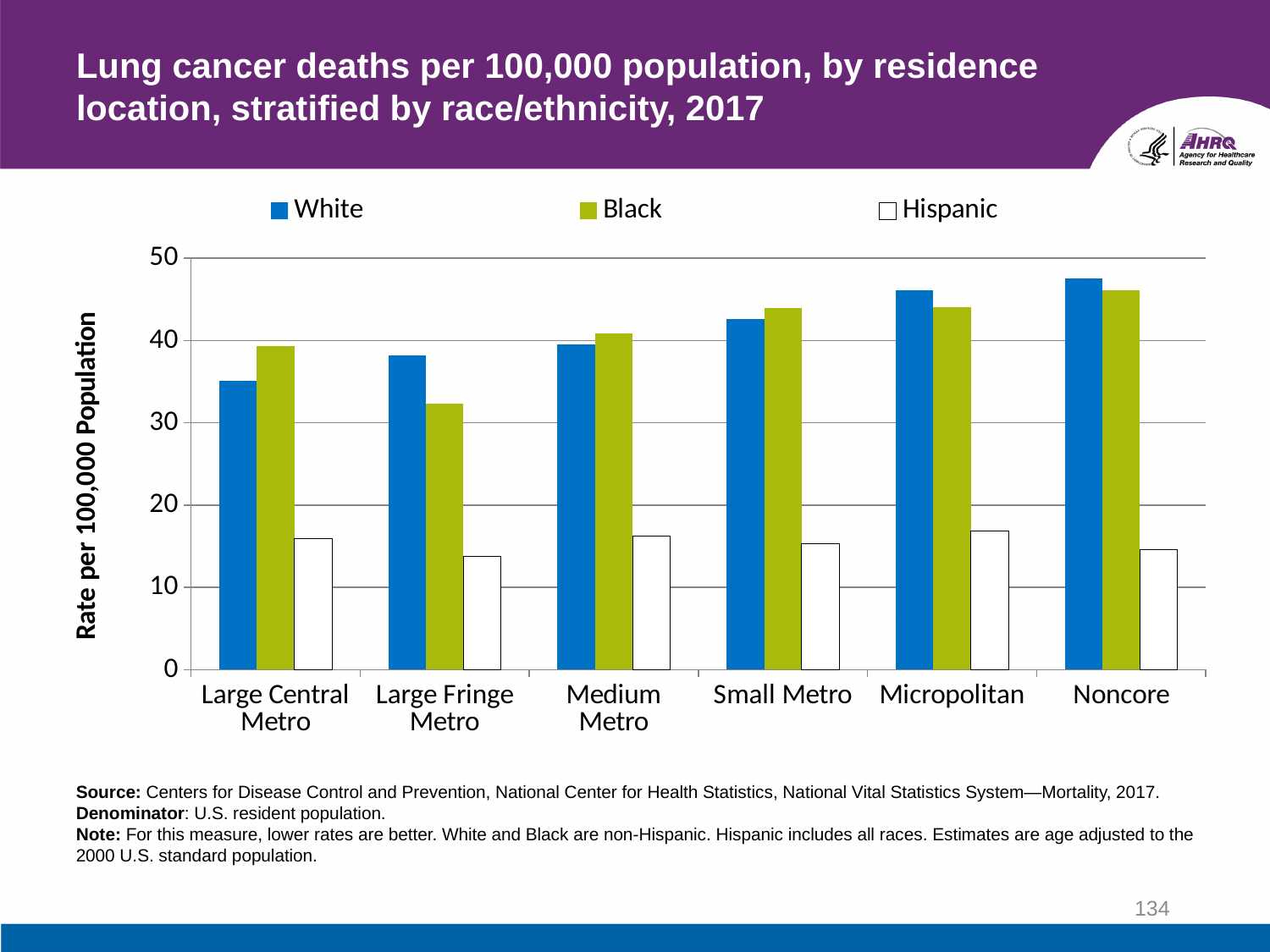
Do the White rates rise or fall moving from Large Central Metro to Noncore along the x axis? rise In Large Central Metro, which is larger: the rate for White or for Black? Black How many residence location categories are shown on the x axis? 6 Which residence location has the lowest lung cancer death rate for Black? Large Fringe Metro In Large Fringe Metro, which is larger: the rate for White or for Black? White Is the rate for Black in Noncore greater or less than 40? greater Is the rate for Hispanic in Large Fringe Metro greater or less than 20? less Is the rate for White in Large Central Metro greater or less than 40? less Which residence location has the lowest lung cancer death rate for White? Large Central Metro Which residence location has the highest lung cancer death rate for White? Noncore How many series does the legend list? 3 What kind of chart is shown on the slide? bar chart